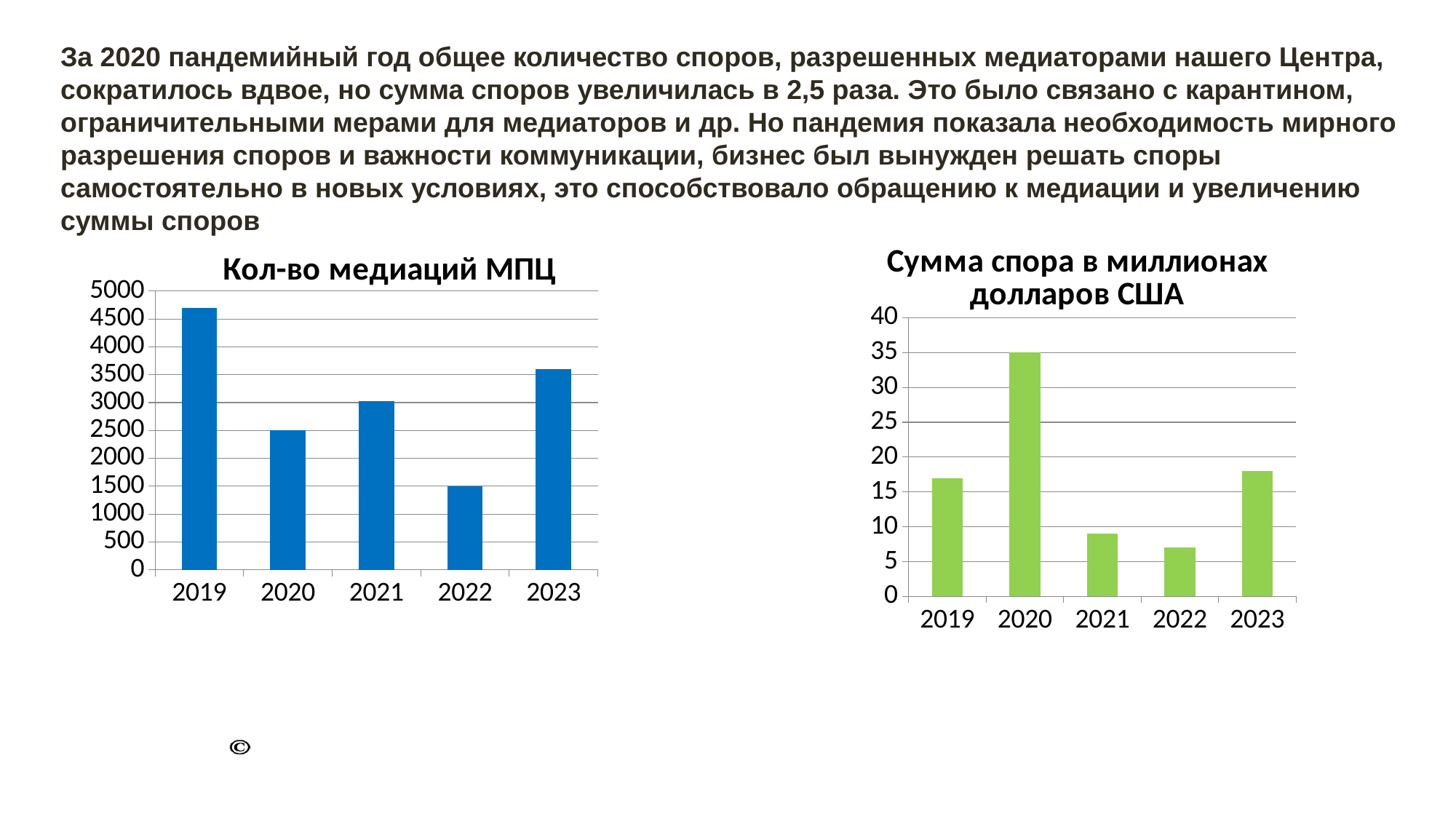
In the 'Сумма спора в миллионах долларов США' chart, which year has the lowest value? 2022 In the 'Кол-во медиаций МПЦ' chart, what is the value for 2020? 2500 In the 'Сумма спора в миллионах долларов США' chart, which is larger, the value for 2019 or the value for 2022? 2019 What kind of chart is the 'Кол-во медиаций МПЦ' chart? bar chart In the 'Кол-во медиаций МПЦ' chart, which year has the highest value? 2019 In the 'Кол-во медиаций МПЦ' chart, which year has the lowest value? 2022 In the 'Сумма спора в миллионах долларов США' chart, is the value for 2021 greater or less than 10? less In the 'Кол-во медиаций МПЦ' chart, is the value for 2019 greater or less than 4500? greater In the 'Кол-во медиаций МПЦ' chart, how many years are shown on the x axis? 5 In the 'Сумма спора в миллионах долларов США' chart, which year has the highest value? 2020 In the 'Сумма спора в миллионах долларов США' chart, what is the value for 2020? 35 In the 'Кол-во медиаций МПЦ' chart, what is the value for 2022? 1500